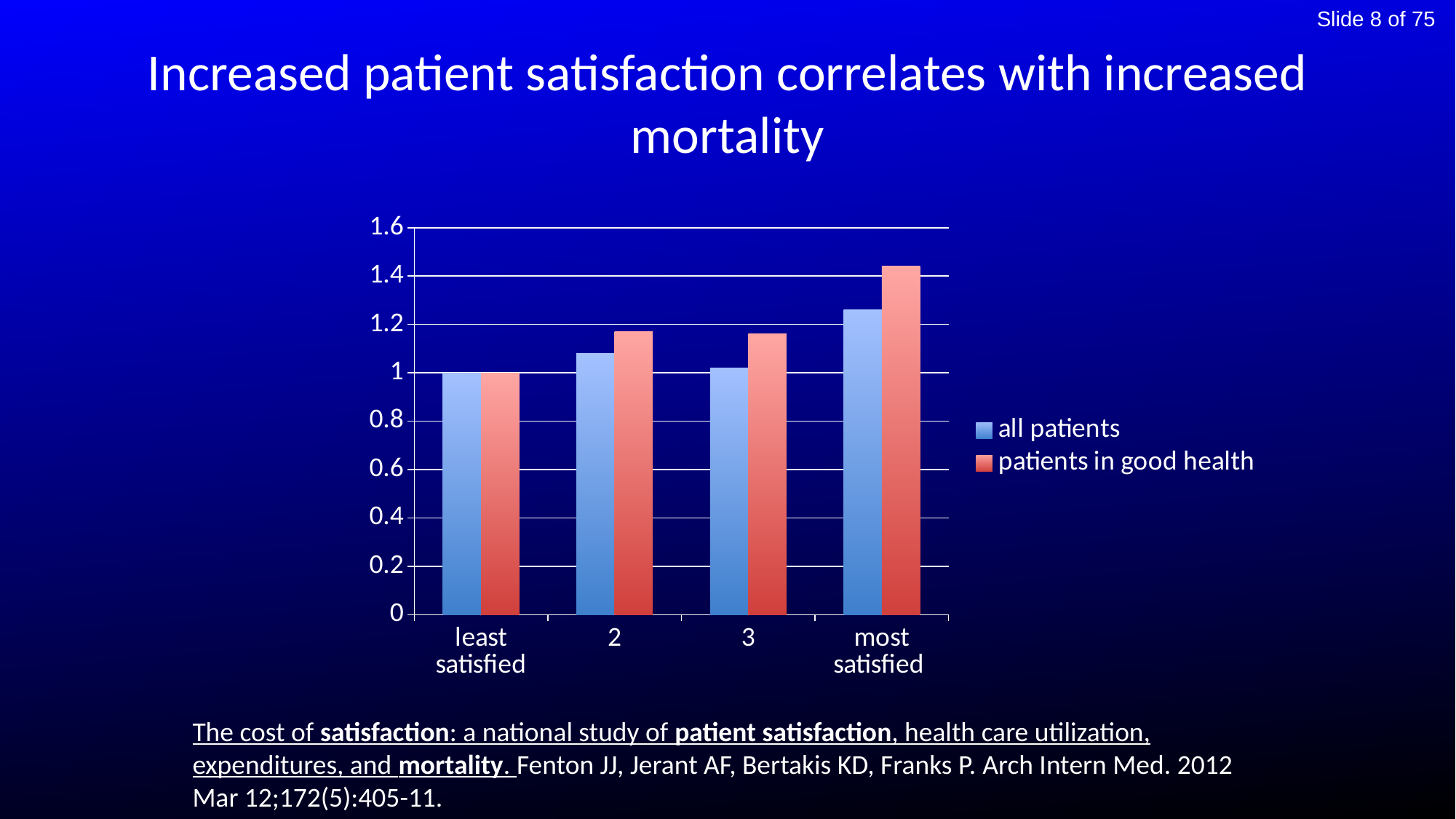
What type of chart is shown on the slide? bar chart How many satisfaction categories are shown on the x axis? 4 Which colour represents the 'patients in good health' series? red How many series does the legend list? 2 Is the value for 'patients in good health' in category 3 greater or less than 1? greater Which category has the lowest value for 'all patients'? least satisfied In the 'most satisfied' category, which series has the larger value: 'all patients' or 'patients in good health'? patients in good health What is the value for 'patients in good health' in the 'least satisfied' category? 1 What is the value for 'all patients' in the 'least satisfied' category? 1 Is the value for 'all patients' in the 'most satisfied' category greater or less than 1.2? greater Is the value for 'patients in good health' in the 'most satisfied' category greater or less than 1.4? greater Which category has the highest value for 'patients in good health'? most satisfied